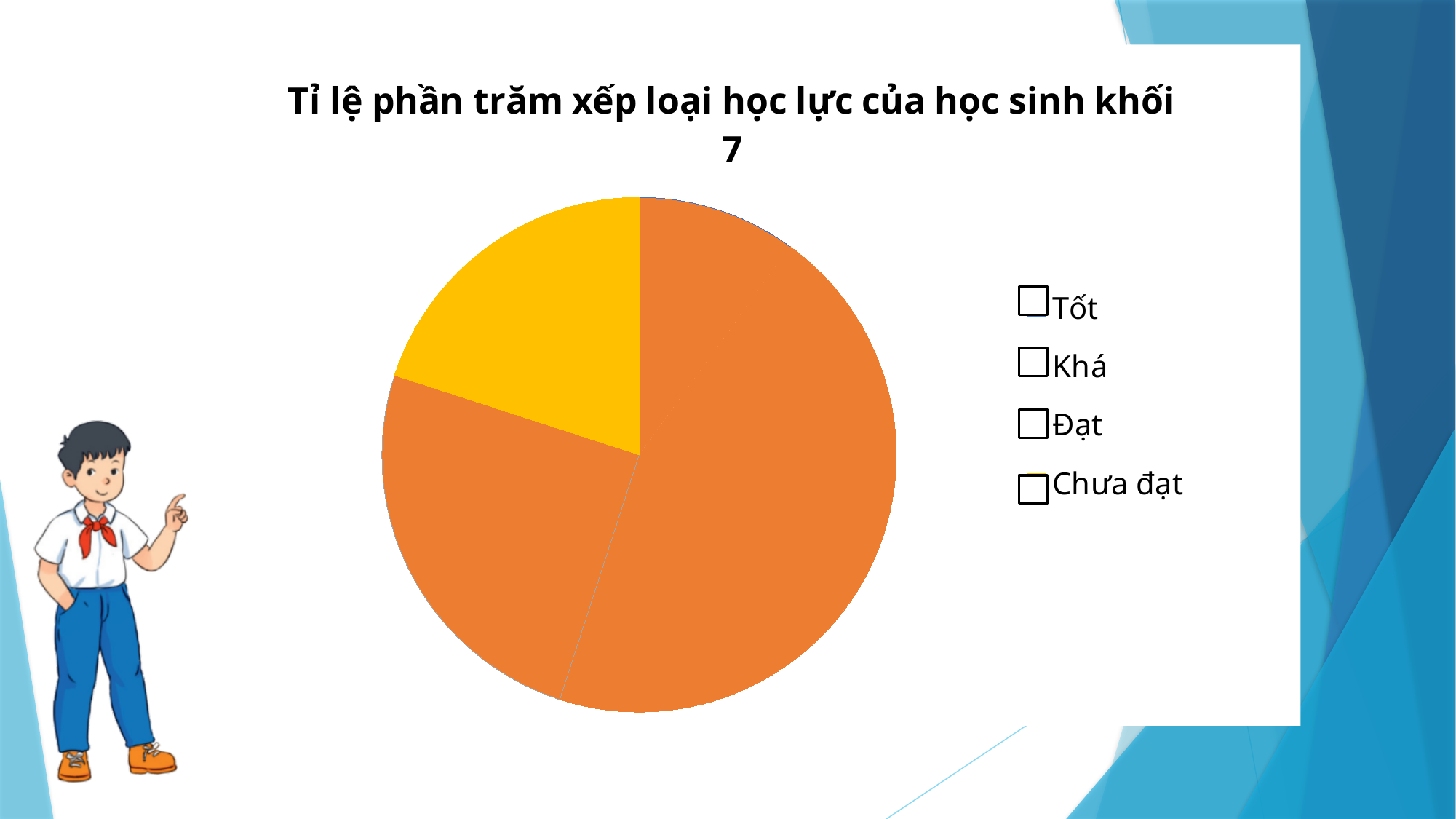
How many entries does the chart's legend list? 4 What colour is the largest slice of the pie? orange What is the title of the chart? Tỉ lệ phần trăm xếp loại học lực của học sinh khối 7 What kind of chart is shown on the slide? pie chart What are the entries listed in the chart's legend? Tốt, Khá, Đạt, Chưa đạt